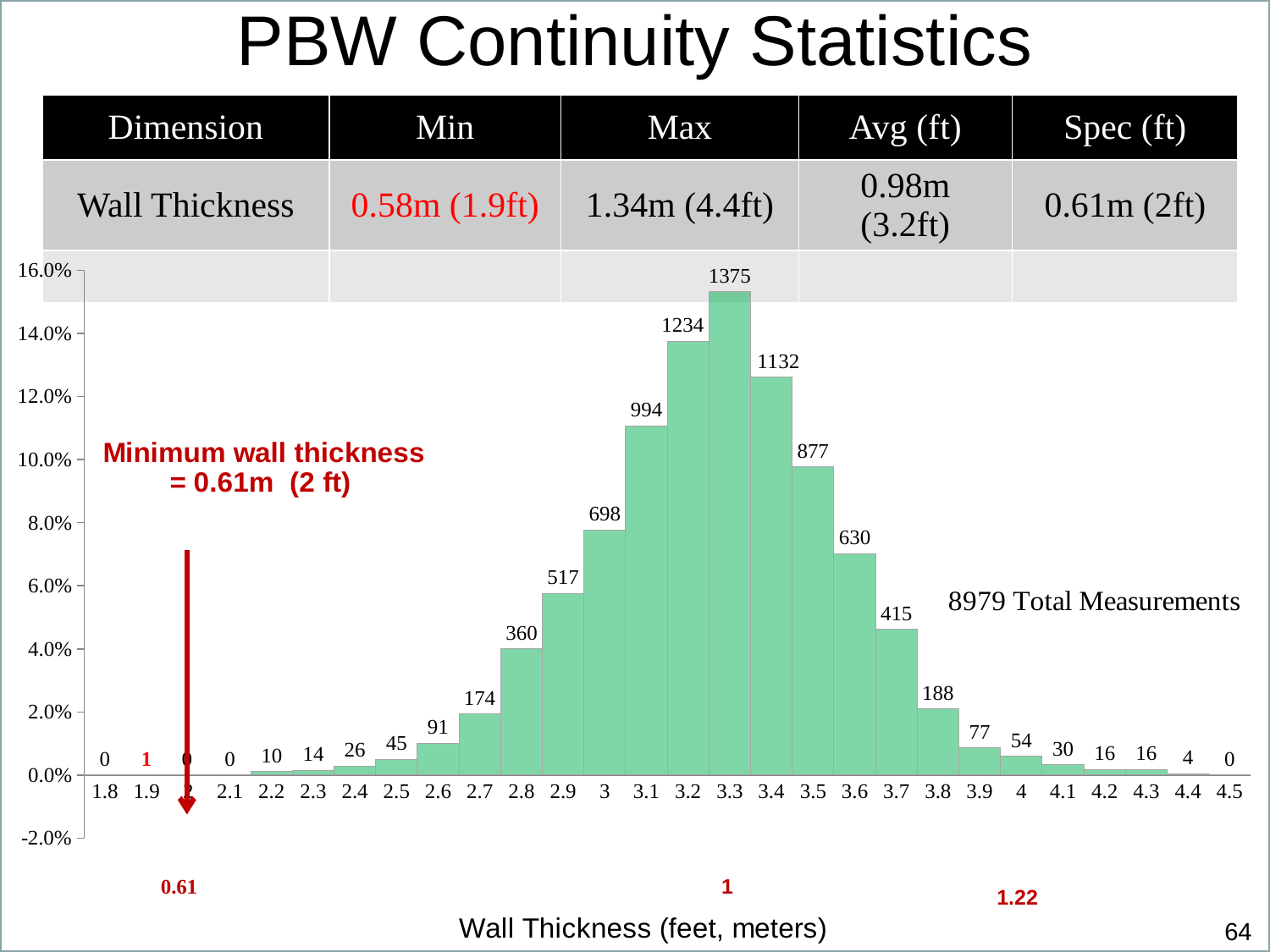
What is the difference between the count labels for 3.3 and 3.2? 141 Which has a larger count label, the bar for 3.1 or the bar for 3.5? 3.1 What kind of chart is shown on the slide? bar chart Which wall thickness category has the tallest bar? 3.3 What count label is shown above the bar for wall thickness 3.8? 188 What is the x-axis title of the chart? Wall Thickness (feet, meters) Do the bar heights rise or fall moving from 3.3 to 4.5 along the x axis? fall Is the bar for wall thickness 3.4 greater or less than 12.0%? greater What count label is shown above the bar for wall thickness 3.3? 1375 Is the bar for wall thickness 3.6 greater or less than 6.0%? greater What count label is shown above the bar for wall thickness 2.8? 360 How many wall thickness categories are shown on the x axis? 28